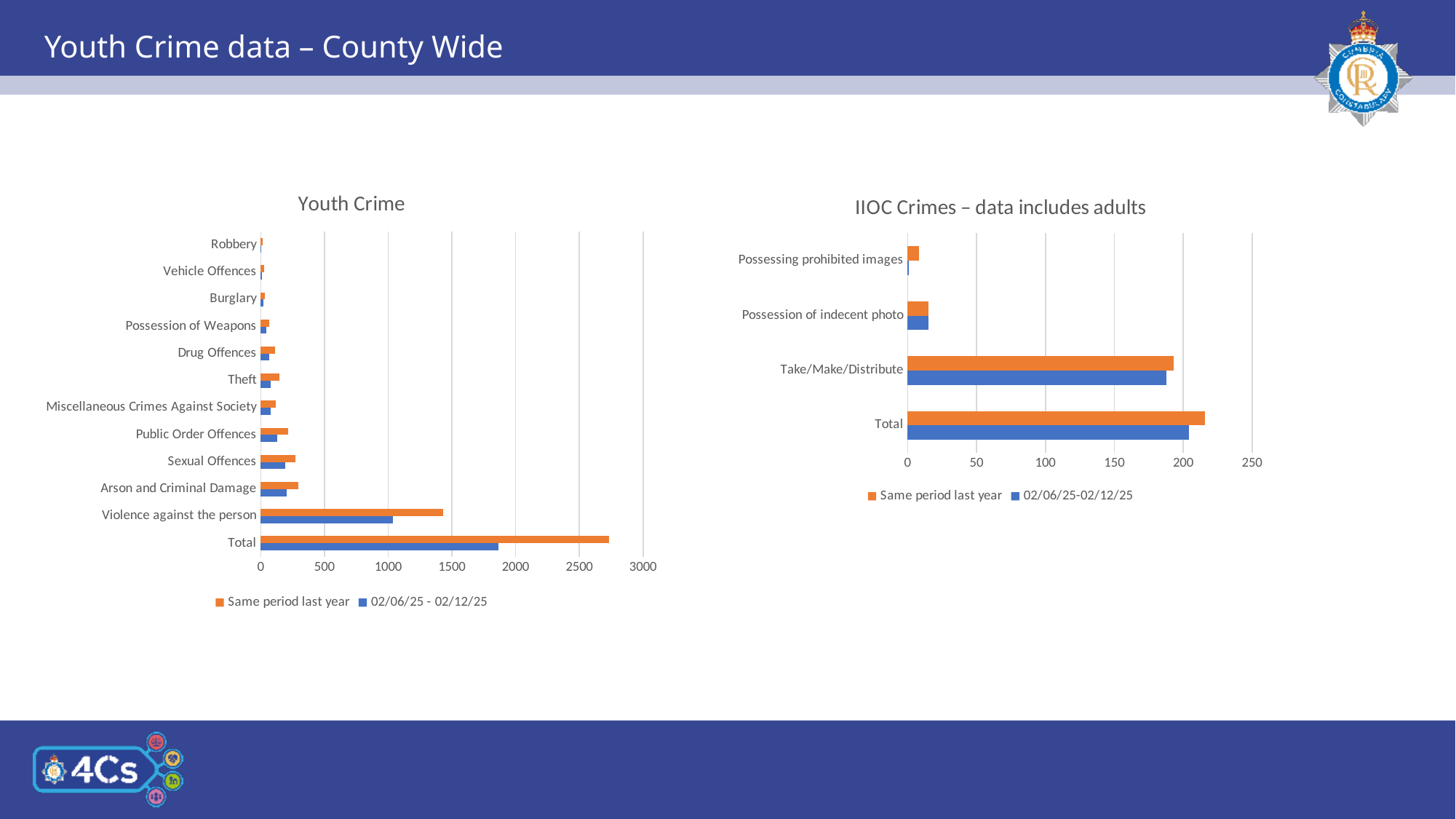
On the Youth Crime chart, is the Total value for 02/06/25 - 02/12/25 greater or less than 2000? less On the IIOC Crimes – data includes adults chart, how many categories are shown? 4 On the IIOC Crimes – data includes adults chart, is the Total value for Same period last year greater or less than 200? greater On the Youth Crime chart, what kind of chart is shown? bar chart On the Youth Crime chart, is the Total value for Same period last year greater or less than 2500? greater On the Youth Crime chart, which series has the larger Total value, Same period last year or 02/06/25 - 02/12/25? Same period last year On the Youth Crime chart, how many categories are listed on the vertical axis? 12 On the Youth Crime chart, excluding Total, which category has the highest value for Same period last year? Violence against the person On the Youth Crime chart, how many series does the legend list? 2 On the IIOC Crimes – data includes adults chart, which series has the larger value for Possessing prohibited images? Same period last year